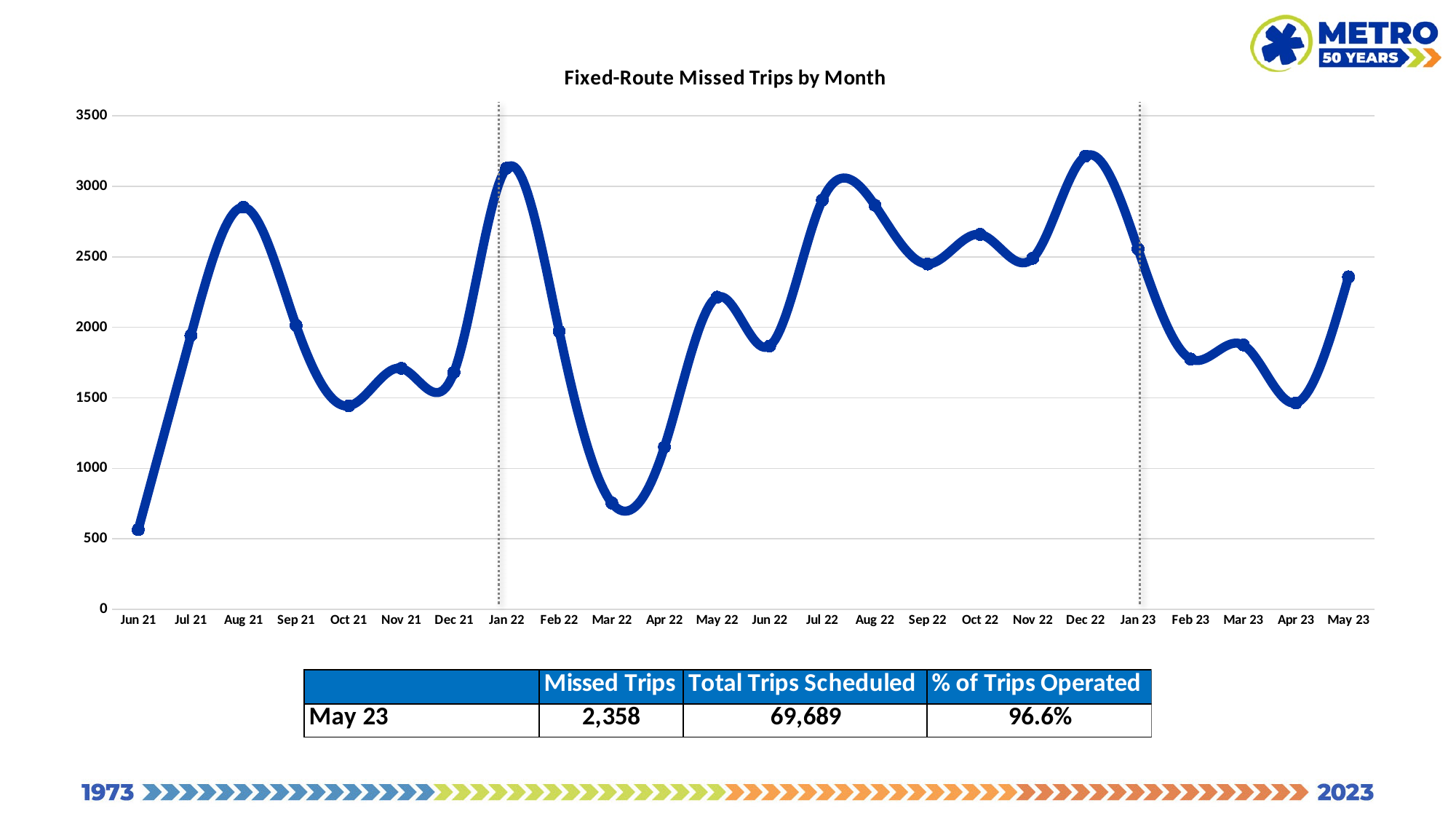
What is the title of the chart? Fixed-Route Missed Trips by Month How many months are plotted on the x axis of the chart? 24 According to the table, what percentage of trips were operated in May 23? 96.6% Do missed trips rise or fall from Jun 21 to Aug 21? rise Is the value for Mar 22 greater or less than 1000? less Which month has more missed trips, Jun 22 or Jul 22? Jul 22 What kind of chart is shown on the slide? line chart Which month has the lowest number of missed trips on the chart? Jun 21 Is the value for Jan 22 greater or less than 3000? greater Is the value for Aug 21 greater or less than 2500? greater According to the table below the chart, how many missed trips were there in May 23? 2,358 According to the table, what was the total number of trips scheduled in May 23? 69,689